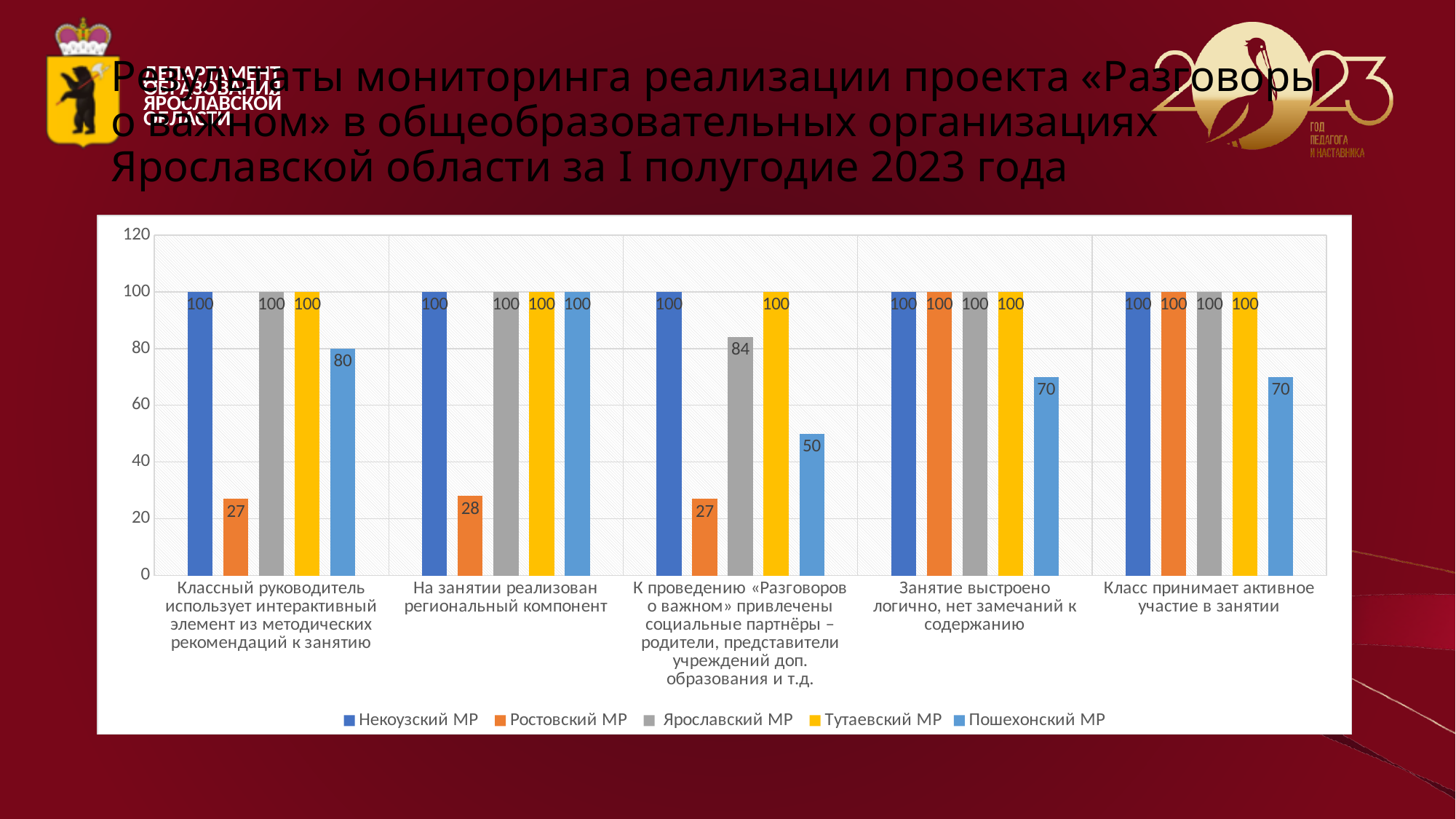
What is the value for Ярославский МР in the category «К проведению «Разговоров о важном» привлечены социальные партнёры»? 84 What kind of chart is shown on the slide? Bar chart What is the difference between Ярославский МР and Пошехонский МР in the category «К проведению «Разговоров о важном» привлечены социальные партнёры»? 34 Which series has the lowest value in the category «Класс принимает активное участие в занятии»? Пошехонский МР What is the difference between Некоузский МР and Ростовский МР in the category «Классный руководитель использует интерактивный элемент из методических рекомендаций к занятию»? 73 What is the value for Ростовский МР in the category «На занятии реализован региональный компонент»? 28 What is the value for Пошехонский МР in the category «Занятие выстроено логично, нет замечаний к содержанию»? 70 How many series does the legend list? 5 In the category «К проведению «Разговоров о важном» привлечены социальные партнёры», which is larger: Ярославский МР or Пошехонский МР? Ярославский МР What is the value for Пошехонский МР in the category «Классный руководитель использует интерактивный элемент из методических рекомендаций к занятию»? 80 Which series has the lowest value in the category «К проведению «Разговоров о важном» привлечены социальные партнёры»? Ростовский МР How many categories are shown on the x axis of the chart? 5